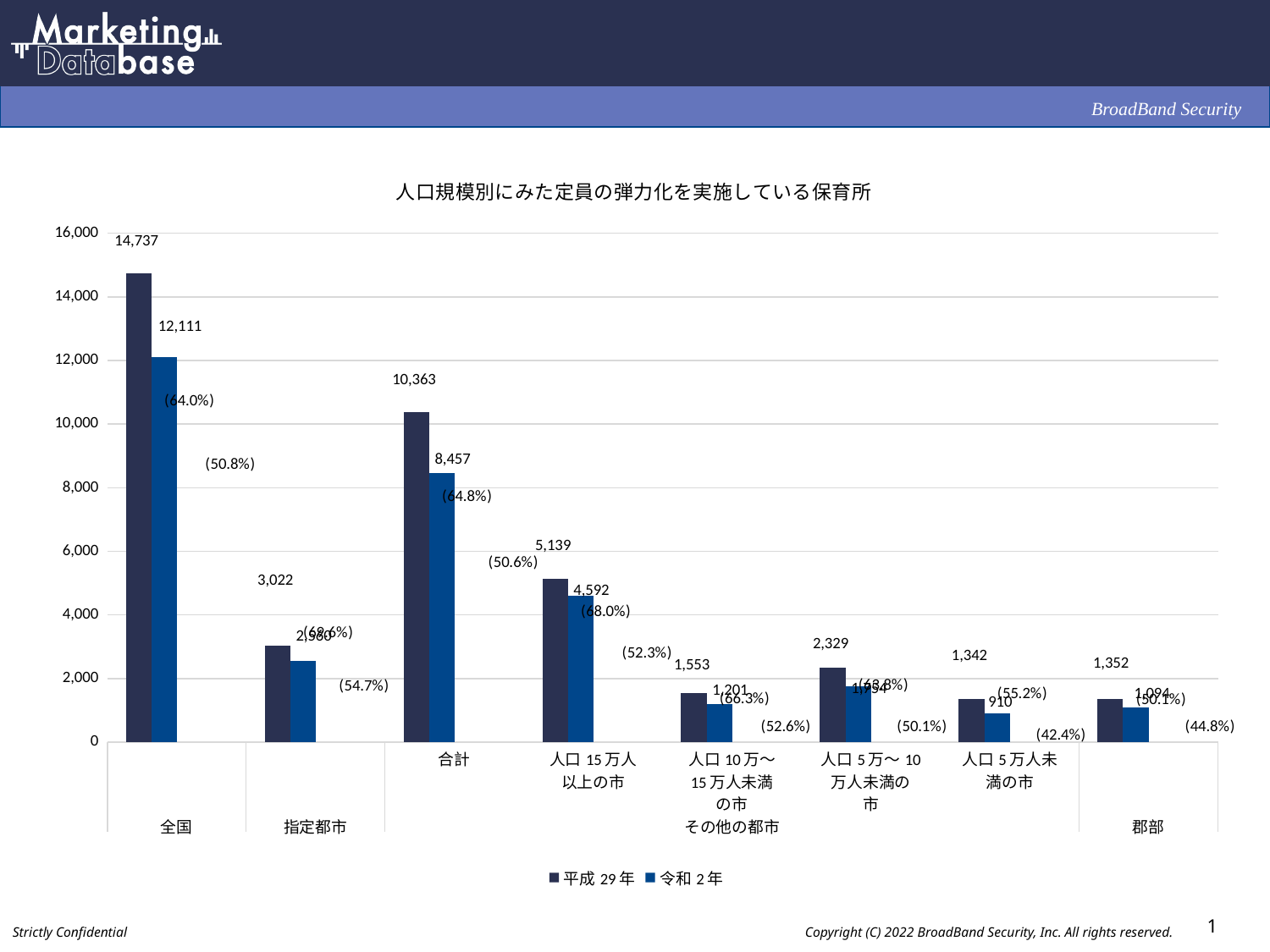
What is the difference between the 平成29年 and 令和2年 values for 全国? 2,626 What is the value for 全国 in the 平成29年 series? 14,737 Which has the larger 平成29年 value, 指定都市 or 人口5万～10万人未満の市? 指定都市 What is the difference between the 平成29年 and 令和2年 values for 合計? 1,906 Which category has the lowest 令和2年 value? 人口5万人未満の市 How many series does the legend list? 2 What is the 令和2年 value for 合計 under その他の都市? 8,457 What is the 令和2年 value for 人口5万人未満の市? 910 What is the value for 全国 in the 令和2年 series? 12,111 What is the 平成29年 value for 人口15万人以上の市? 5,139 Is the 令和2年 value for 指定都市 greater or less than 2,000? greater Which category has the highest 平成29年 value? 全国